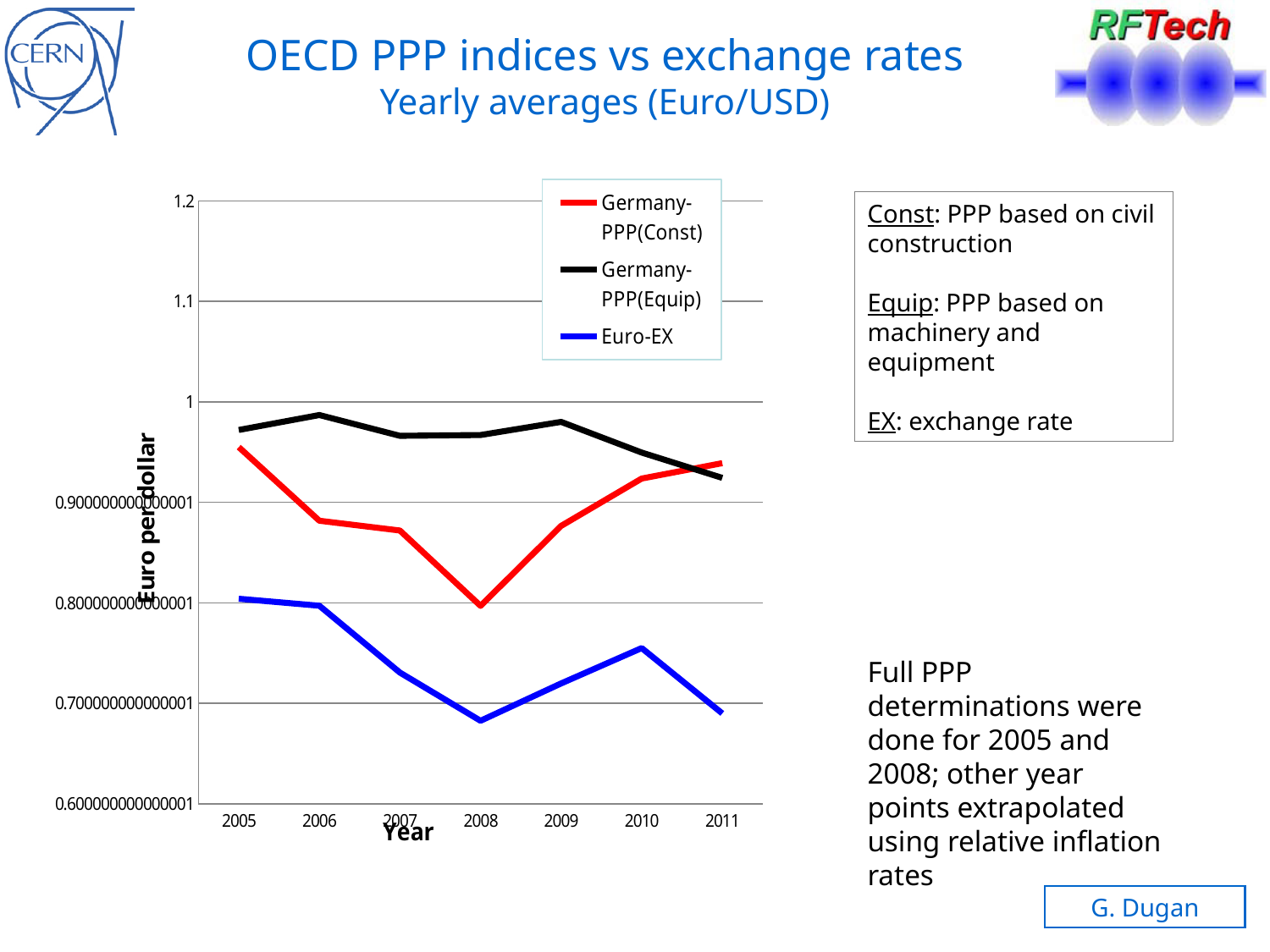
Is the value for Euro-EX in 2010 greater or less than 0.7? greater What is the title of the chart's vertical axis? Euro per dollar Is the value for Euro-EX in 2008 greater or less than 0.7? less In which year is the Euro-EX value lowest? 2008 How many series does the chart legend list? 3 What kind of chart is shown on the slide? line chart Does the Germany-PPP(Const) series rise or fall from 2008 to 2011? rise How many years are plotted along the x axis of the chart? 7 In which year is the Germany-PPP(Equip) value highest? 2006 Is the value for Germany-PPP(Equip) in 2011 greater or less than 0.9? greater In 2008, which series has the higher value, Germany-PPP(Equip) or Germany-PPP(Const)? Germany-PPP(Equip)